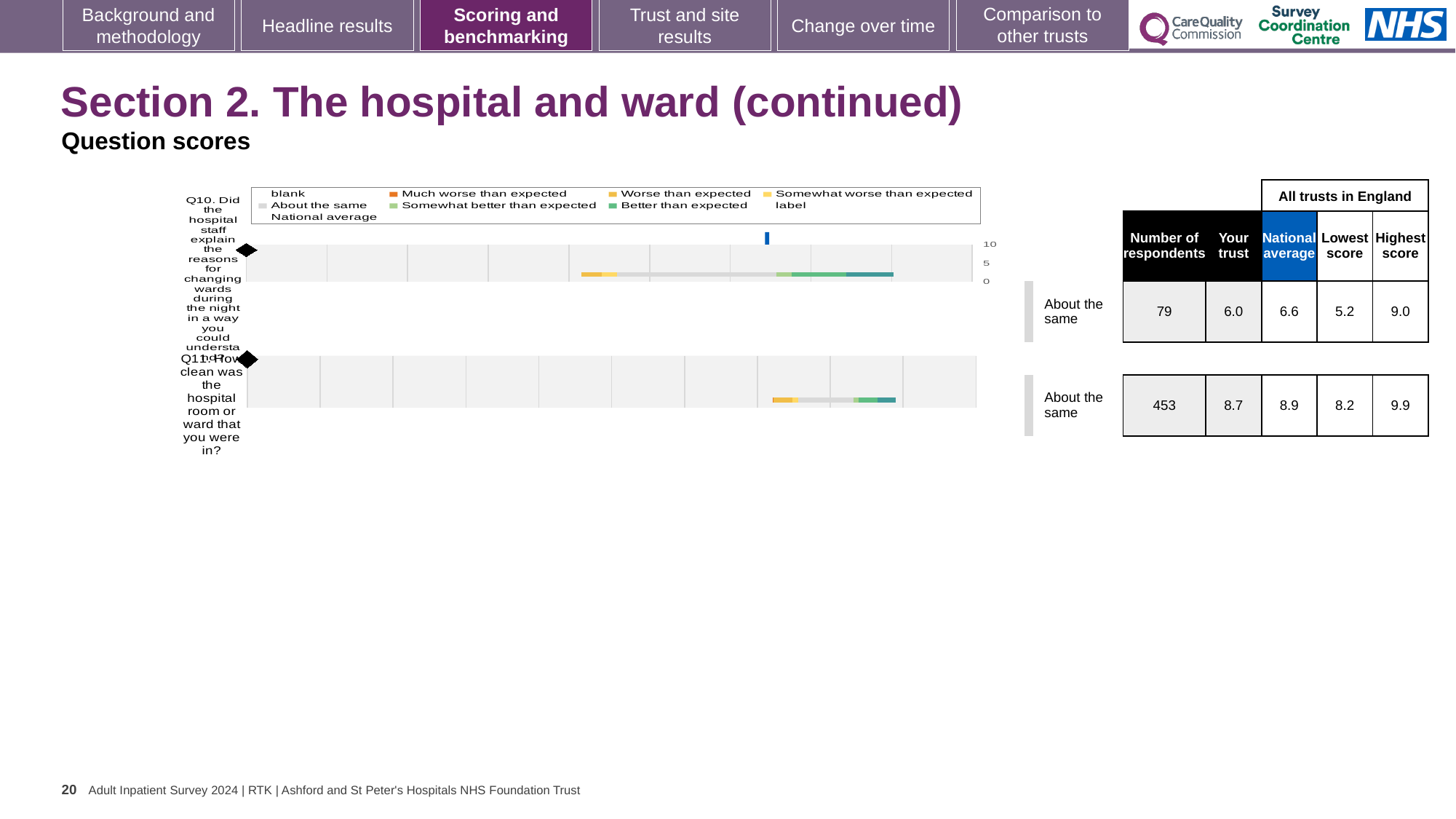
What is the highest score among all trusts in England for Q11? 9.9 What is the national average score for Q11? 8.9 What is the lowest score among all trusts in England for Q10? 5.2 How many entries does the chart legend list? 9 What kind of chart is shown on the slide? bar chart How many respondents answered Q10? 79 How many survey questions are plotted in the chart? 2 What is the 'Your trust' score for Q10? 6.0 What benchmark category is shown for Q10? About the same What is the difference between the highest score and the lowest score for Q11? 1.7 Which question has the higher 'Your trust' score, Q10 or Q11? Q11 For Q10, which is larger: the 'Your trust' score or the national average? National average